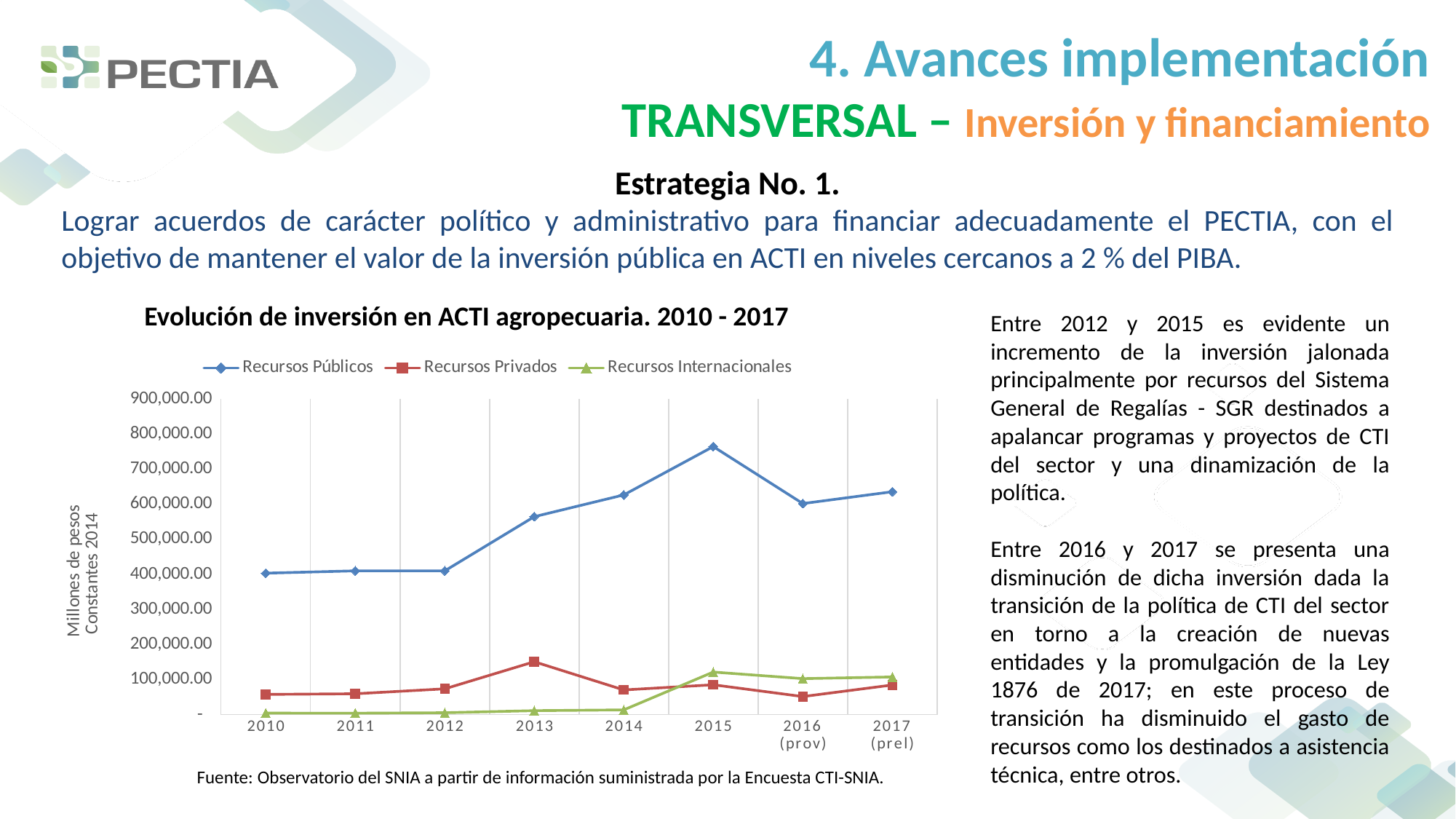
In which year does the Recursos Privados series reach its highest value? 2013 Is the value for Recursos Privados in 2013 greater or less than 100,000.00? greater Does the Recursos Públicos series rise or fall between 2012 and 2015? Rise How many years are plotted along the x axis of the chart? 8 Is the value for Recursos Internacionales in 2014 greater or less than 100,000.00? less In which year does the Recursos Públicos series reach its highest value? 2015 What kind of chart is shown on the slide? Line chart Which series has the larger value in 2013, Recursos Públicos or Recursos Privados? Recursos Públicos Is the value for Recursos Públicos in 2010 greater or less than 500,000.00? less What is the title of the chart? Evolución de inversión en ACTI agropecuaria. 2010 - 2017 How many series does the legend of the chart list? 3